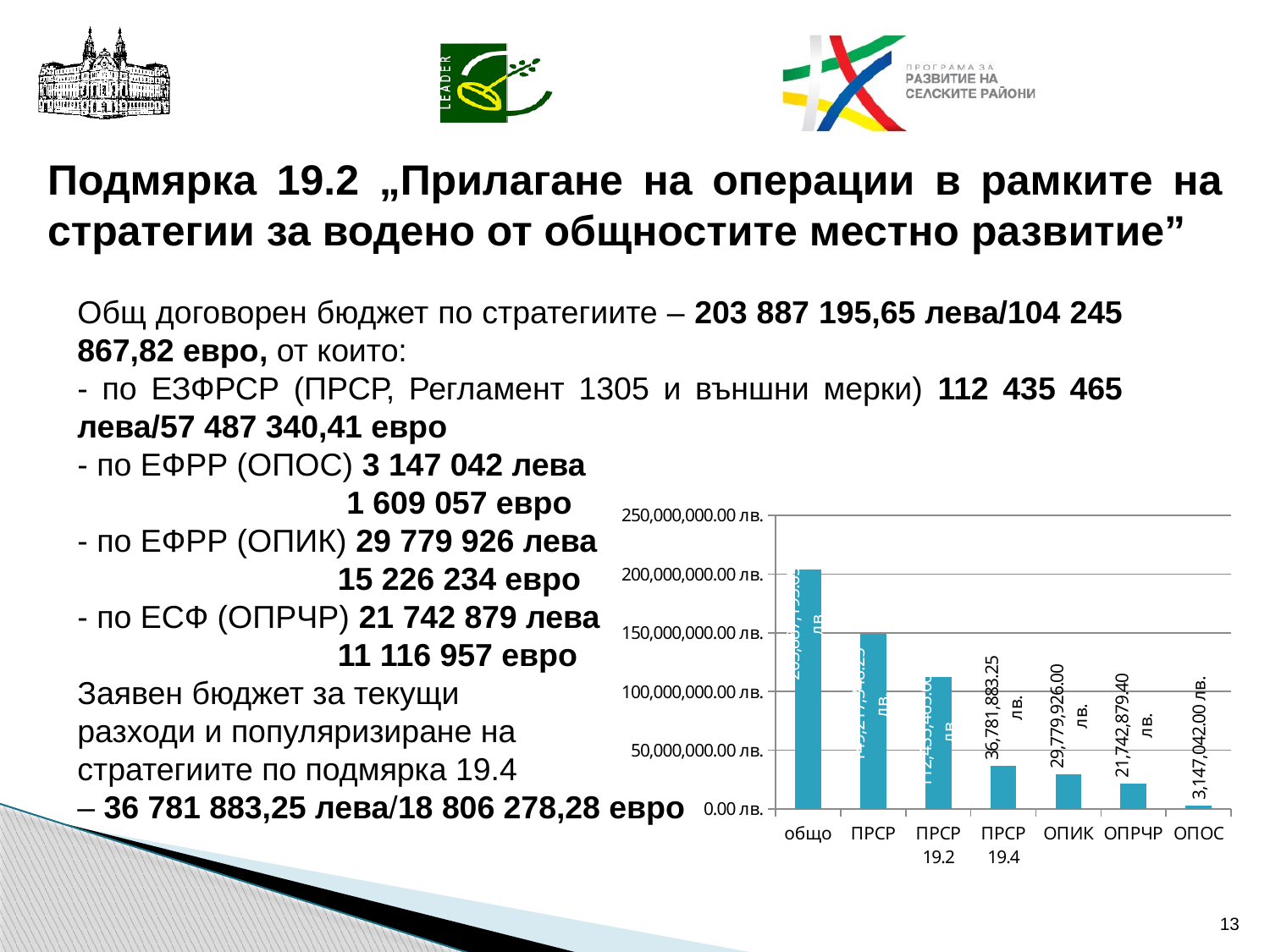
Is the value for ПРСР 19.2 greater or less than 150,000,000.00 лв.? less Which category has the highest value in the chart? общо What is the value shown for ОПРЧР in the chart? 21,742,879.40 лв. What is the value shown for ПРСР 19.4 in the chart? 36,781,883.25 лв. What is the value shown for ОПОС in the chart? 3,147,042.00 лв. What is the value shown for ОПИК in the chart? 29,779,926.00 лв. What kind of chart is shown on the slide? bar chart Which category has the lowest value in the chart? ОПОС Is the value for ПРСР greater or less than 100,000,000.00 лв.? greater Which is larger in the chart, the value for ОПИК or the value for ОПРЧР? ОПИК How many categories are plotted on the x axis of the chart? 7 What is the difference between the values for ОПИК and ОПРЧР in the chart? 8,037,046.60 лв.